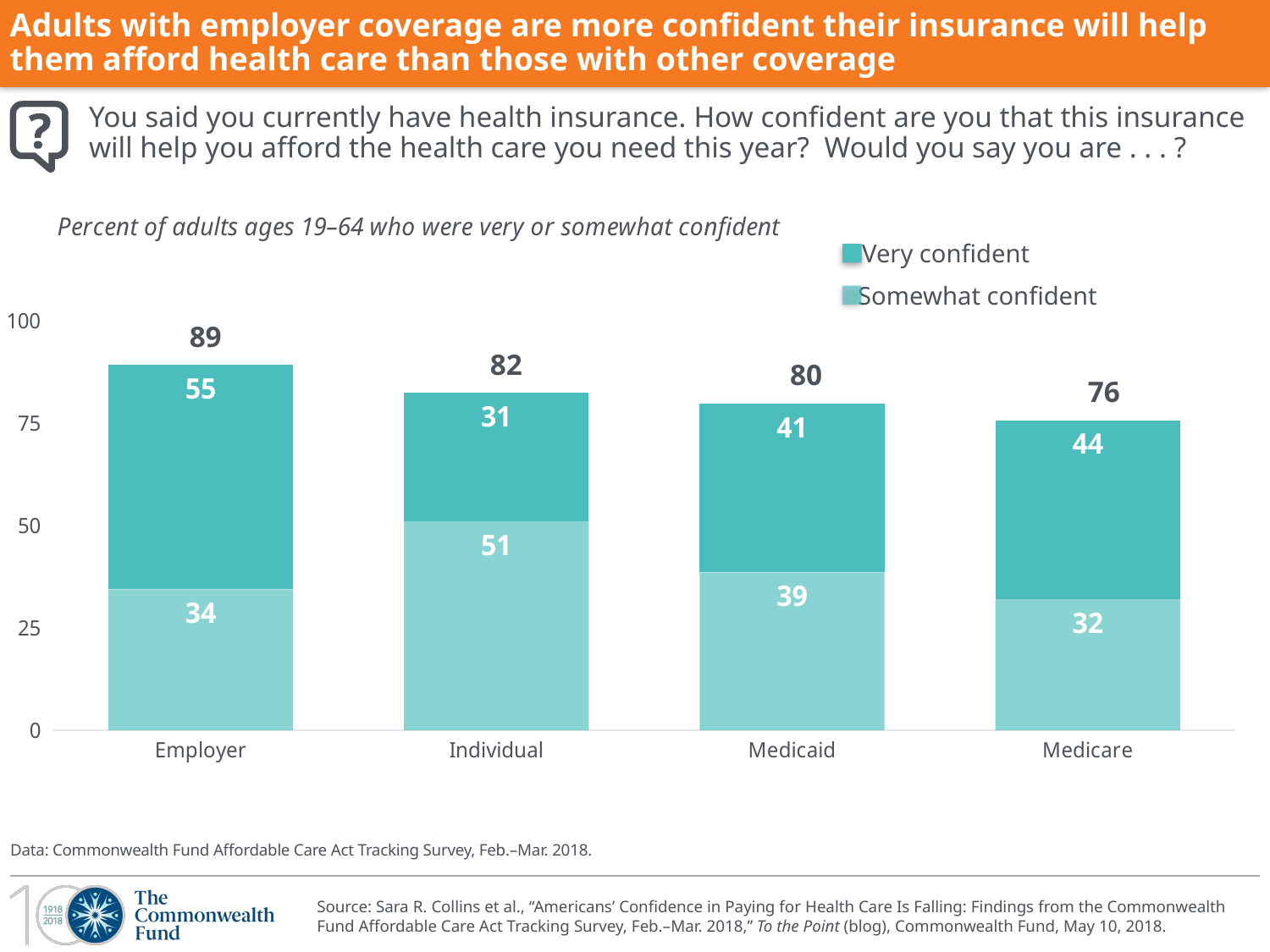
Which coverage category has the highest total percent of adults who were very or somewhat confident? Employer How many series does the legend list? 2 What is the total (very or somewhat confident) for Medicaid? 80 Which coverage category has the lowest total percent of adults who were very or somewhat confident? Medicare How many coverage categories are shown on the x axis? 4 What is the difference between the total for Employer and the total for Medicare? 13 What is the 'Very confident' value for Employer? 55 Is the total for Individual greater or less than 75? greater What are the two legend entries? Very confident; Somewhat confident Which is larger, the 'Very confident' value for Medicaid or the 'Very confident' value for Medicare? Medicare What kind of chart is shown on the slide? Stacked bar chart What is the 'Somewhat confident' value for Individual? 51